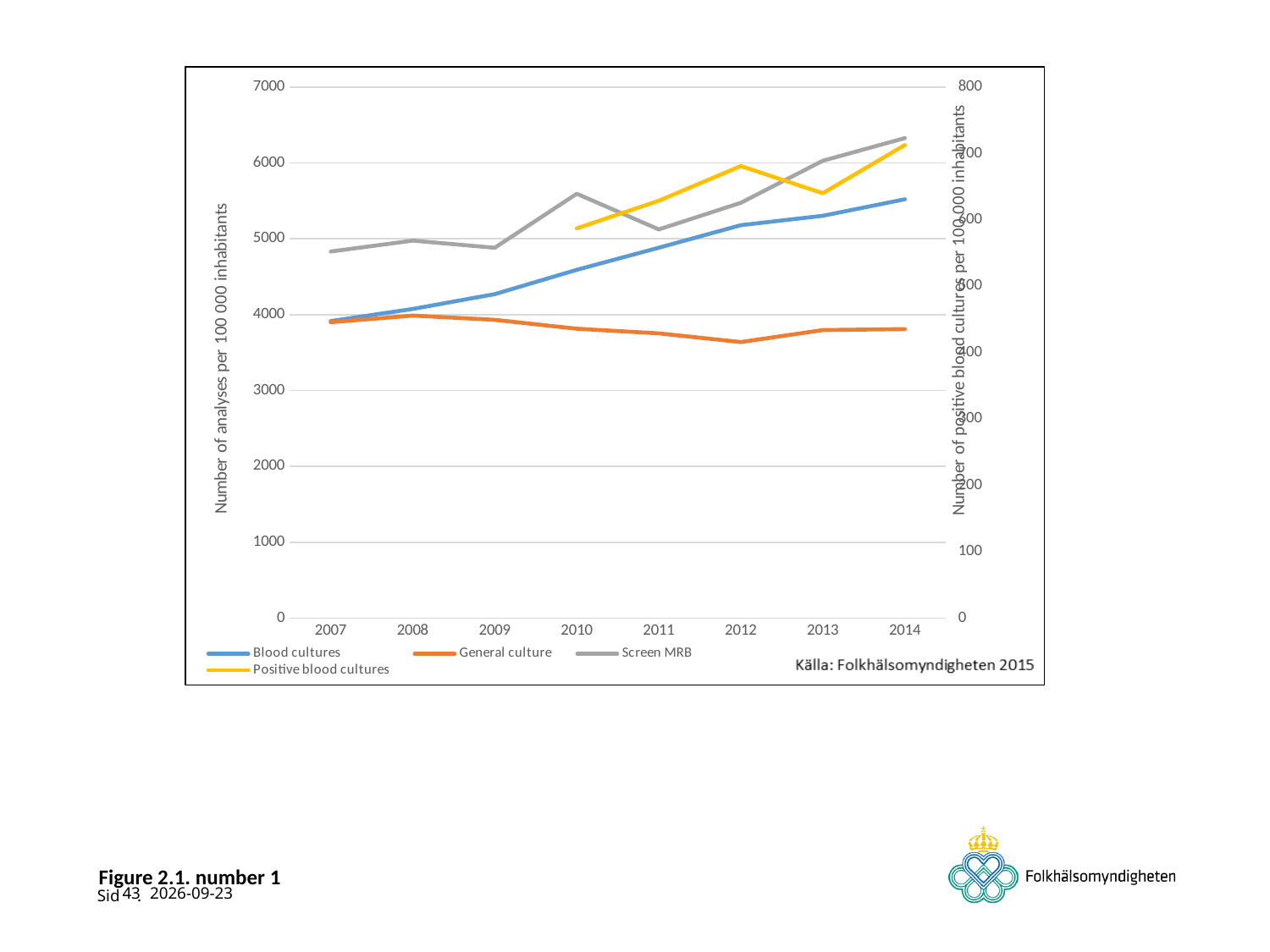
In which year is the value for General culture lowest? 2012 What kind of chart is shown on the slide? line chart Is the value for Screen MRB in 2007 greater or less than 5000? less Do the values for Screen MRB rise or fall from 2007 to 2014? rise Which series only starts in 2010? Positive blood cultures How many series does the legend list? 4 Do the values for Blood cultures rise or fall from 2007 to 2014? rise In 2014, which is higher on the left axis: Screen MRB or Blood cultures? Screen MRB Is the value for General culture in 2012 greater or less than 4000? less Is the value for Blood cultures in 2014 greater or less than 5000? greater How many years are shown on the x axis? 8